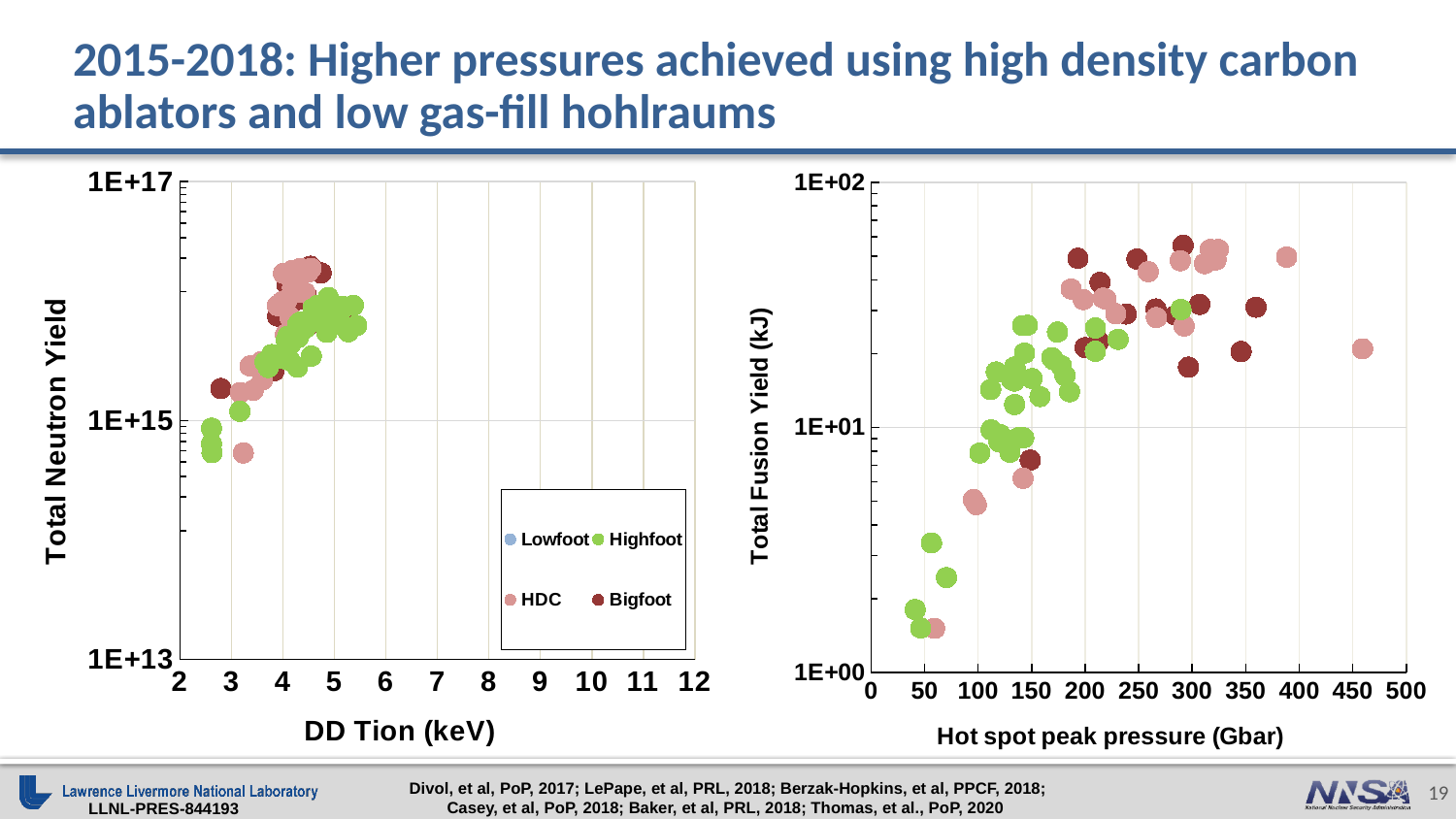
On the left chart, are the Bigfoot points at about 4.5 keV greater or less than 1E+15? greater What is the x-axis title of the right chart? Hot spot peak pressure (Gbar) What kind of chart is the left chart (Total Neutron Yield vs DD Tion)? scatter chart On the right chart, which series has the point at the highest hot spot peak pressure? HDC On the left chart, does Total Neutron Yield generally rise or fall as DD Tion increases? rise On the left chart, are the lowest Highfoot points (around 2.7 keV) greater or less than 1E+15? less Which series is plotted in green? Highfoot On the right chart, is the HDC point at about 460 Gbar greater or less than 1E+01 kJ? greater On the right chart, which series has the points at the lowest hot spot peak pressure? Highfoot How many series does the legend list? 4 On the right chart, does Total Fusion Yield generally rise or fall as hot spot peak pressure increases? rise